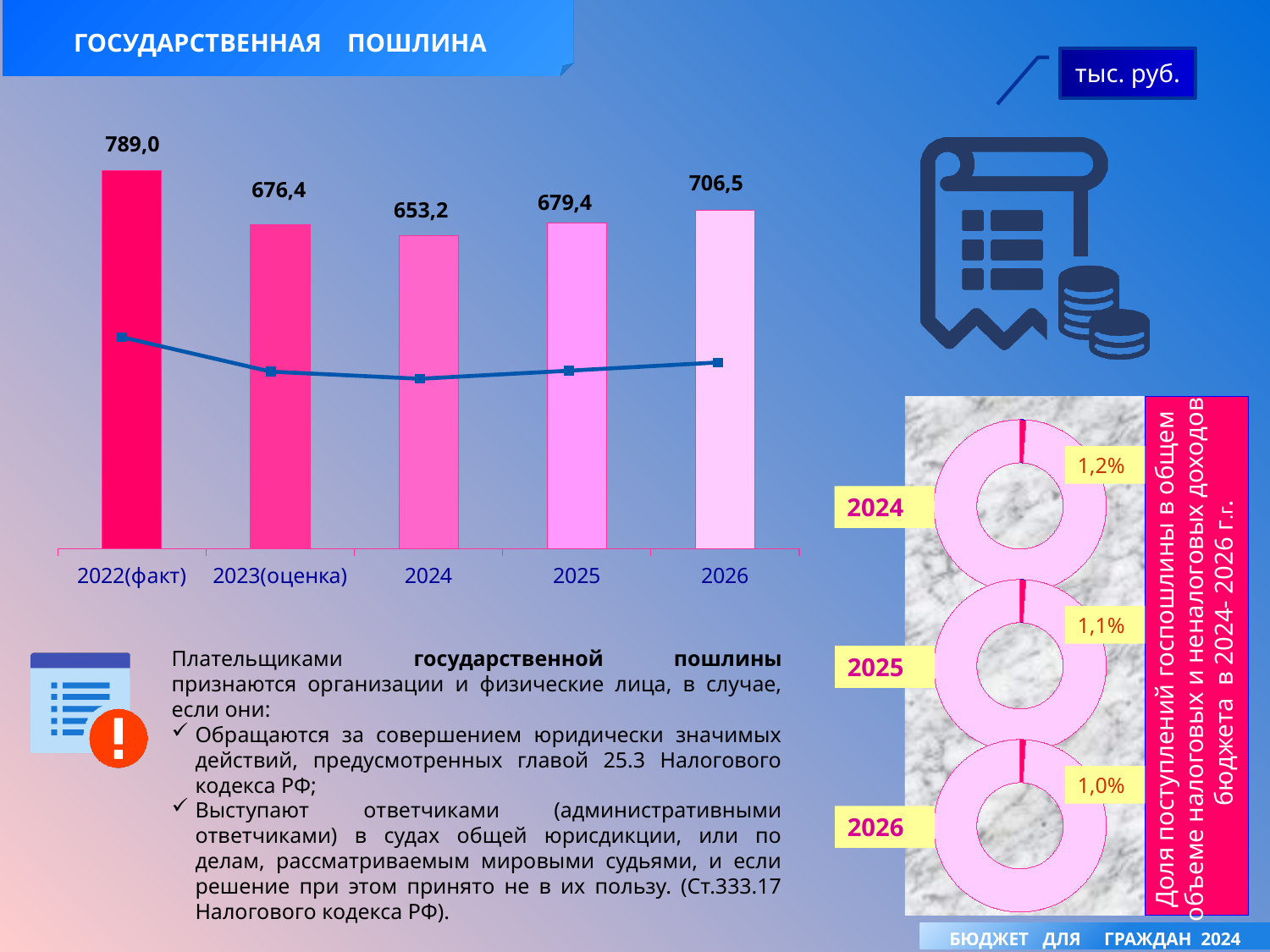
In the bar chart, what is the value for 2024? 653,2 In the donut charts on the right, what share is shown for 2026? 1,0% In the bar chart, what is the difference between the values for 2022(факт) and 2024? 135,8 How many categories are shown on the x axis of the bar chart? 5 In the bar chart, which category has the lowest value? 2024 Do the values in the bar chart rise or fall from 2024 to 2026? rise In the bar chart, what is the value for 2026? 706,5 In the bar chart, which is larger: the value for 2023(оценка) or the value for 2025? 2025 In the bar chart, what is the value for 2022(факт)? 789,0 In the bar chart, which category has the highest value? 2022(факт) In the donut charts on the right, what share is shown for 2024? 1,2% In the bar chart, what is the difference between the values for 2026 and 2025? 27,1